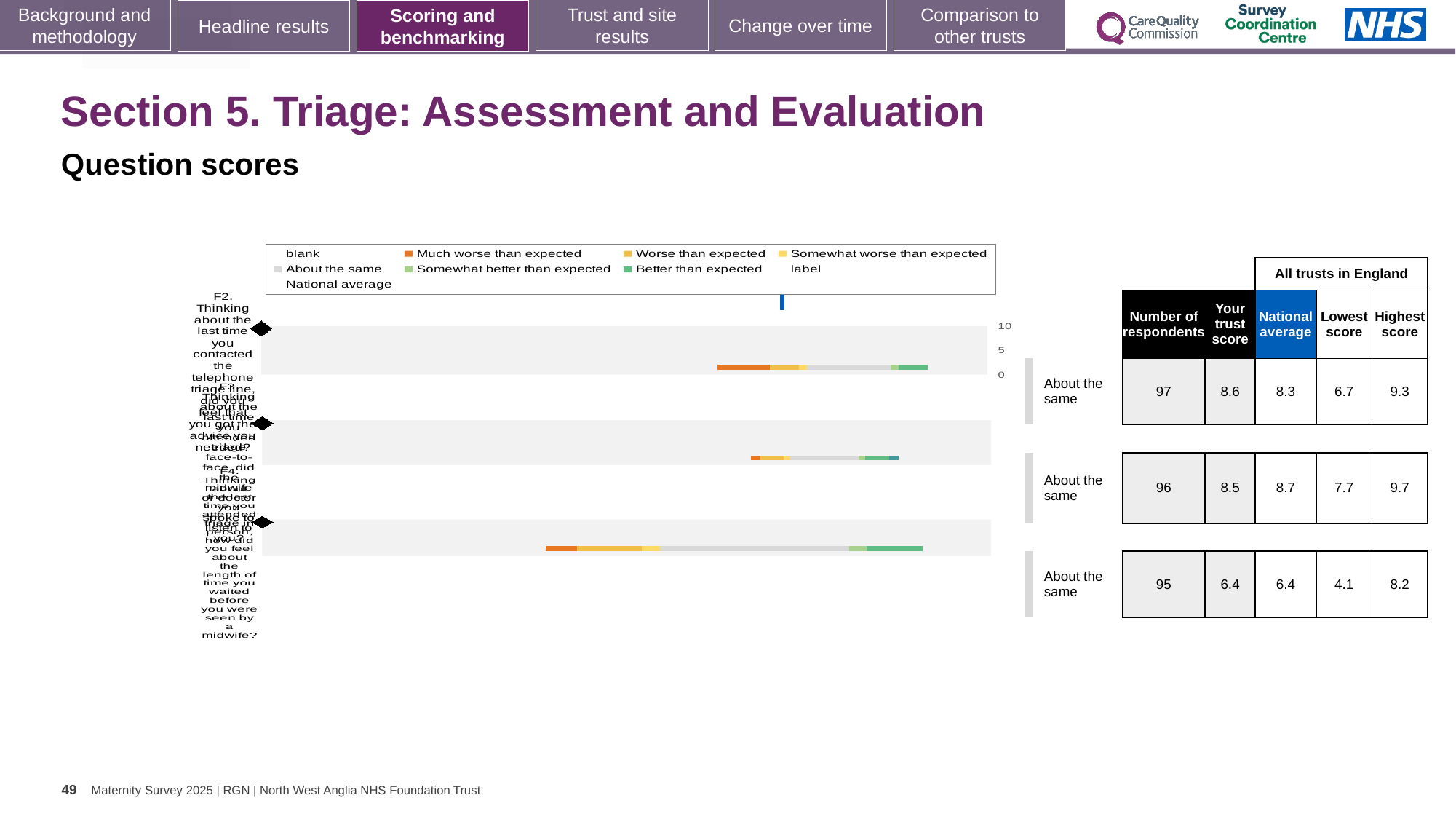
What benchmark category is shown beside each of the three bars in the chart? About the same What is the highest value shown on the chart's axis? 10 In the table next to the chart, what is the lowest score for the third row? 4.1 In the table next to the chart, what is the national average for the second row? 8.7 What colour represents 'Much worse than expected' in the chart legend? orange In the table next to the chart, which row has the lowest number of respondents? the third row (95) In the table next to the chart, what is the number of respondents for the first row? 97 In the table next to the chart, what is the difference between the highest score and the lowest score for the third row? 4.1 In the table next to the chart, what is 'Your trust score' for the first row? 8.6 In the table next to the chart, which is larger for the first row: 'Your trust score' or the national average? Your trust score What kind of chart is shown on the slide? bar chart How many question bars are plotted in the chart? 3